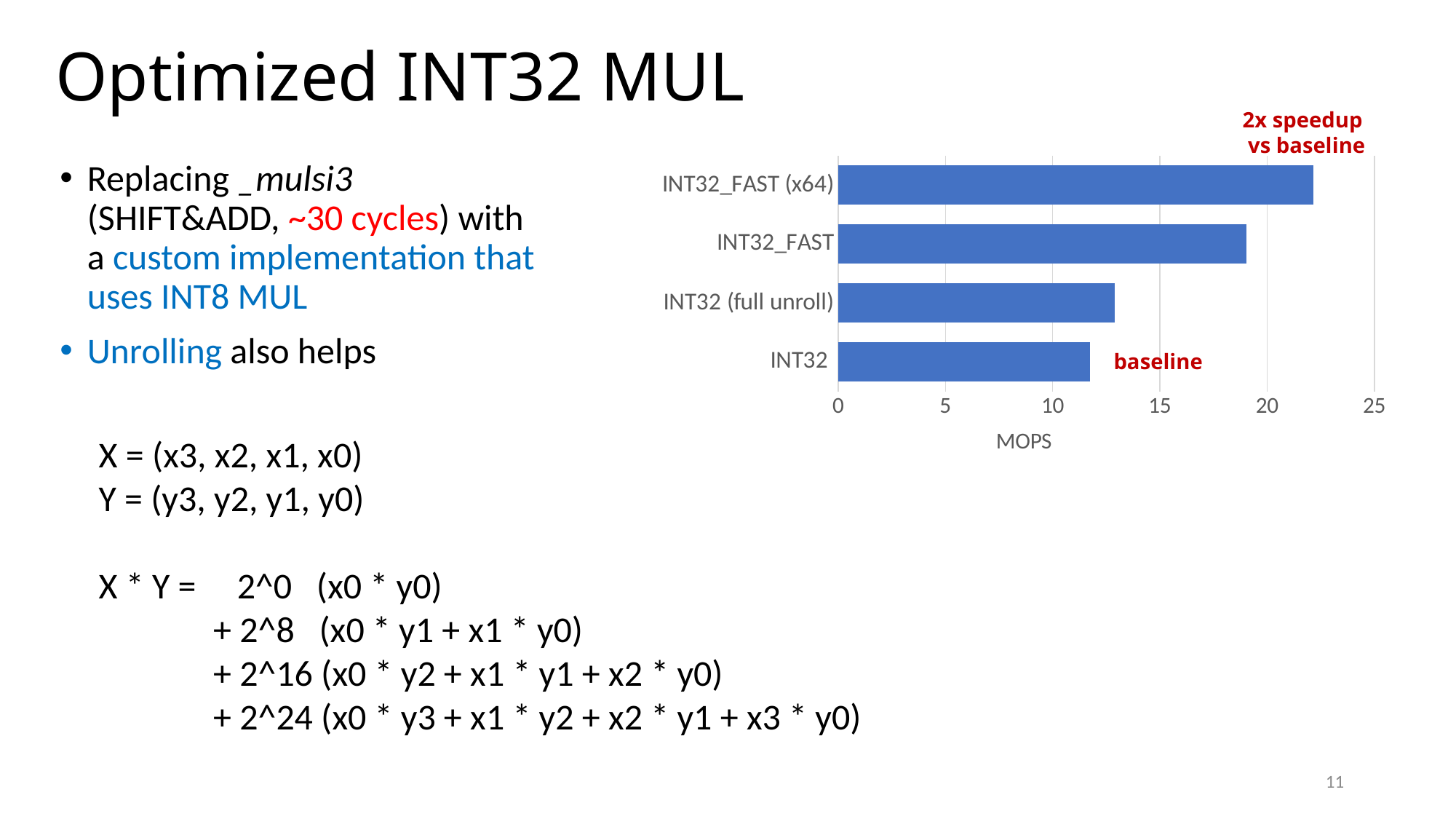
Which has a higher MOPS value, INT32_FAST or INT32 (full unroll)? INT32_FAST What kind of chart is shown on the slide? bar chart What is the label of the horizontal axis of the chart? MOPS Which has a higher MOPS value, INT32_FAST (x64) or INT32_FAST? INT32_FAST (x64) Is the value for INT32 greater or less than 15? less Which category has the highest MOPS value? INT32_FAST (x64) Is the value for INT32_FAST (x64) greater or less than 20? greater How many categories (bars) does the chart show? 4 Which bar is annotated as the baseline in the chart? INT32 Which category has the lowest MOPS value? INT32 Is the value for INT32 (full unroll) greater or less than 10? greater